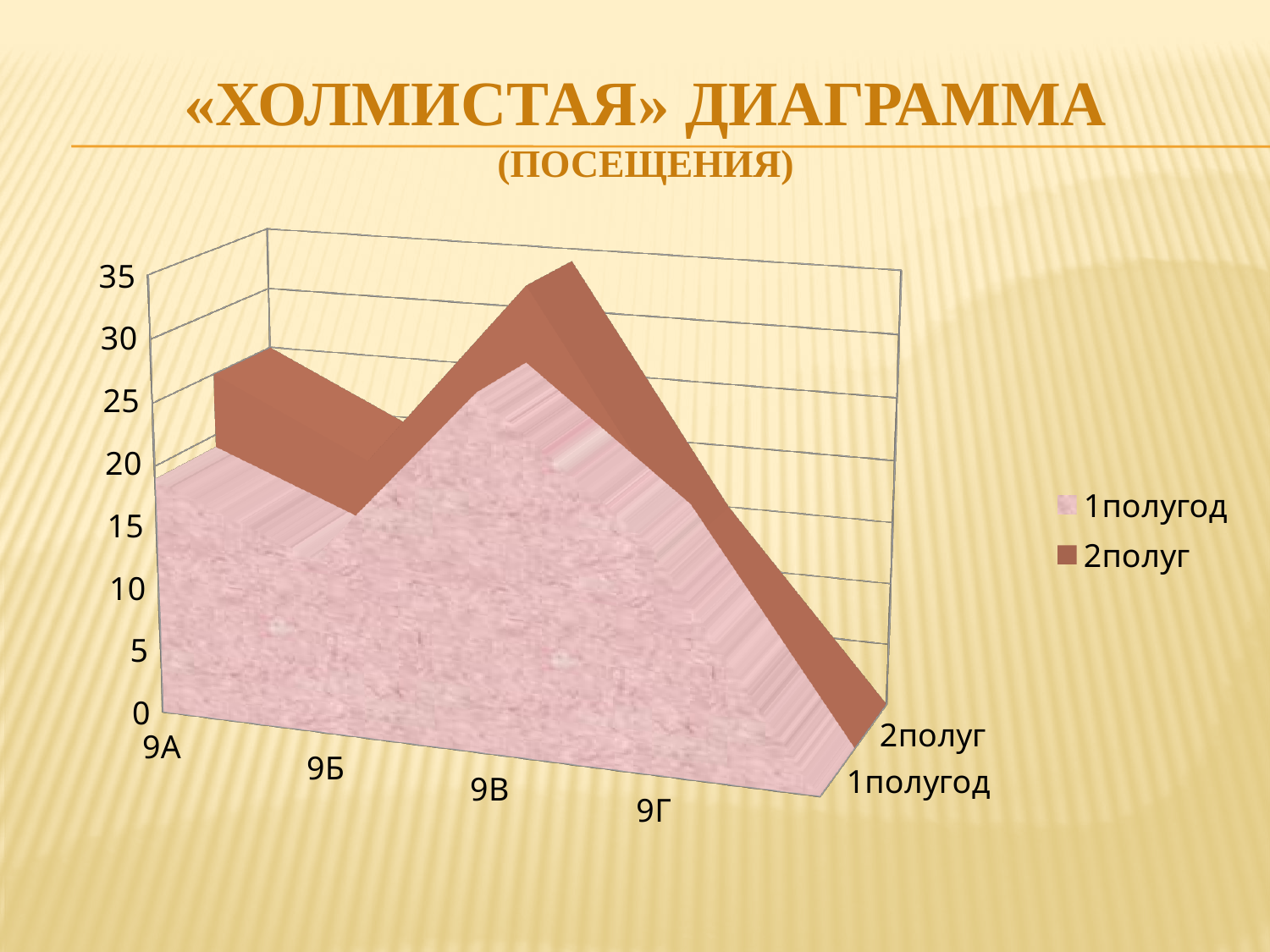
In the series 2полуг, which is larger: the value for 9В or the value for 9А? 9В For the series 1полугод, which category has the highest value? 9В In the series 1полугод, which is larger: the value for 9В or the value for 9Б? 9В For the series 2полуг, which category has the highest value? 9В How many series does the legend list? 2 What kind of chart is shown on the slide? area chart Is the value for 9В in the series 1полугод greater or less than 20? greater How many categories are shown on the x axis? 4 What is the title of the chart on the slide? «ХОЛМИСТАЯ» ДИАГРАММА (ПОСЕЩЕНИЯ) Which series is shown in the darker brown colour? 2полуг Is the value for 9Б in the series 1полугод greater or less than 25? less Is the value for 9А in the series 1полугод greater or less than 15? greater